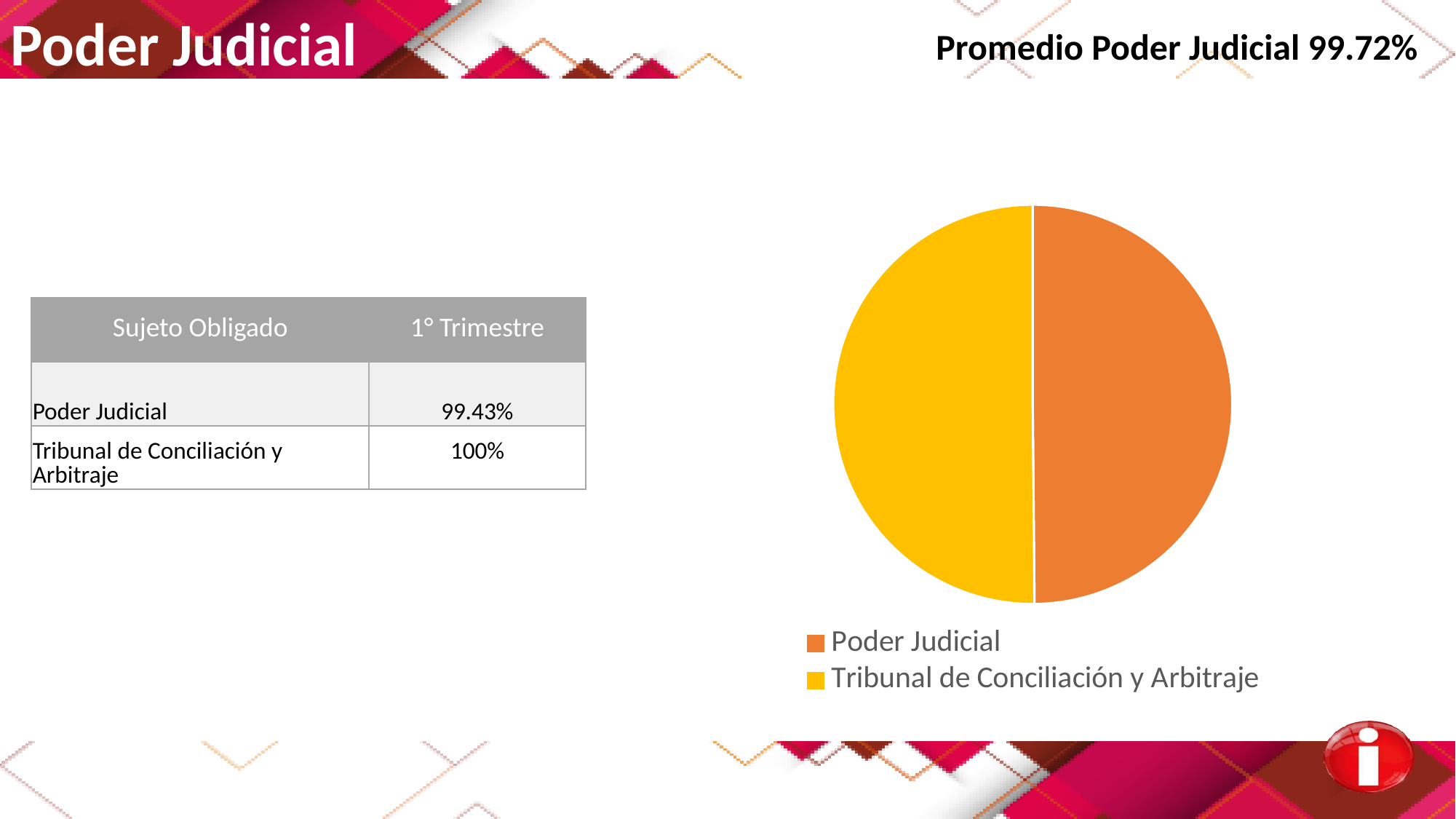
Based on the values printed in the table, what is the difference between the 1° Trimestre values of Tribunal de Conciliación y Arbitraje and Poder Judicial? 0.57% According to the table on the slide, what is the 1° Trimestre value for Poder Judicial? 99.43% Based on the values printed in the table, which has the higher 1° Trimestre value: Poder Judicial or Tribunal de Conciliación y Arbitraje? Tribunal de Conciliación y Arbitraje Which colour represents Poder Judicial in the pie chart? orange How many entries does the pie chart's legend list? 2 What kind of chart is shown on the slide? pie chart How many slices does the pie chart have? 2 According to the table on the slide, what is the 1° Trimestre value for Tribunal de Conciliación y Arbitraje? 100% What is the Promedio Poder Judicial value stated at the top of the slide? 99.72% Which colour represents Tribunal de Conciliación y Arbitraje in the pie chart? yellow